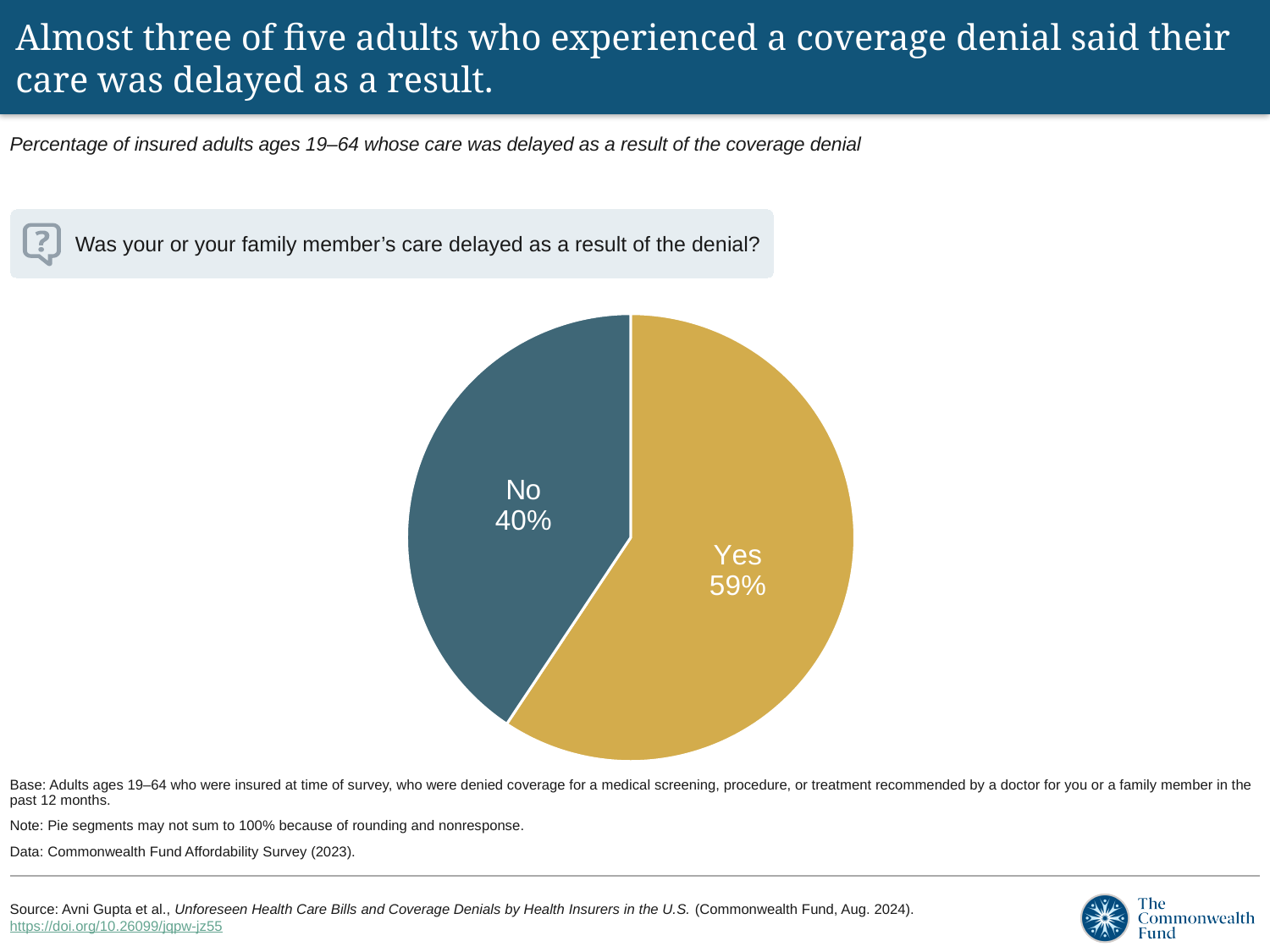
Which response has the larger share of the pie? Yes What is the difference in percentage points between the Yes and No slices? 19 How many slices does the pie chart have? 2 What colour is the Yes slice? gold What survey question does the pie chart answer? Was your or your family member's care delayed as a result of the denial? What share of the pie does the No slice represent? 40% Which response has the smaller share of the pie? No What percentage of respondents answered Yes? 59% Is the value for Yes greater or less than 50%? greater Is the Yes slice larger or smaller than the No slice? larger What percentage of respondents answered No? 40% What kind of chart is shown on the slide? pie chart